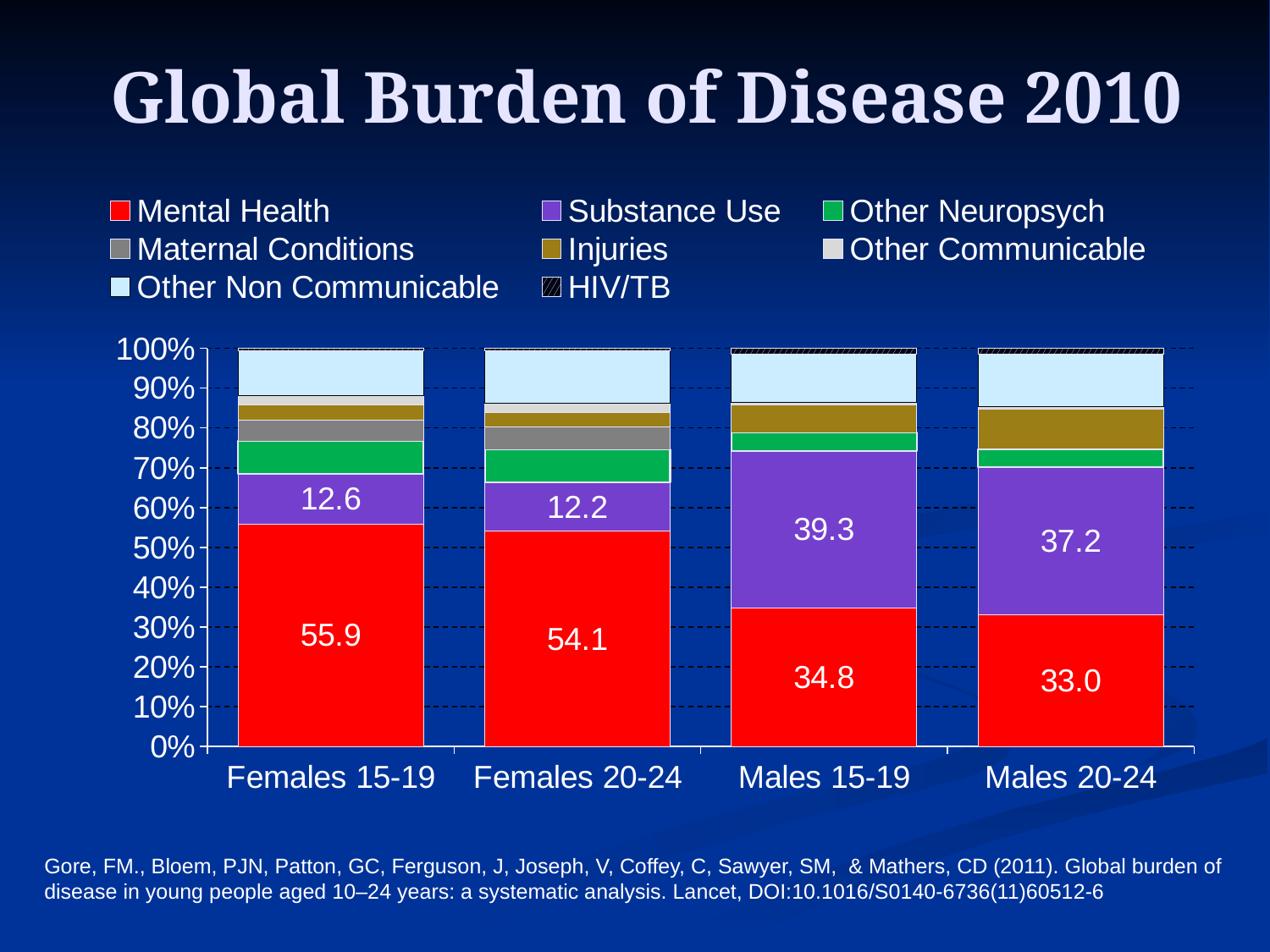
What is the Mental Health value for Males 20-24? 33.0 What is the Mental Health value for Females 15-19? 55.9 What is the Substance Use value for Males 15-19? 39.3 Which category has the lowest Substance Use value? Females 20-24 How many series does the legend list? 8 Which is larger: the Substance Use value for Males 15-19 or for Males 20-24? Males 15-19 What is the difference between the Mental Health values for Females 15-19 and Females 20-24? 1.8 What kind of chart is shown on the slide? Stacked bar chart How many categories are shown on the x axis? 4 What is the Substance Use value for Females 20-24? 12.2 What colour represents Mental Health in the chart? Red Which category has the highest Mental Health value? Females 15-19